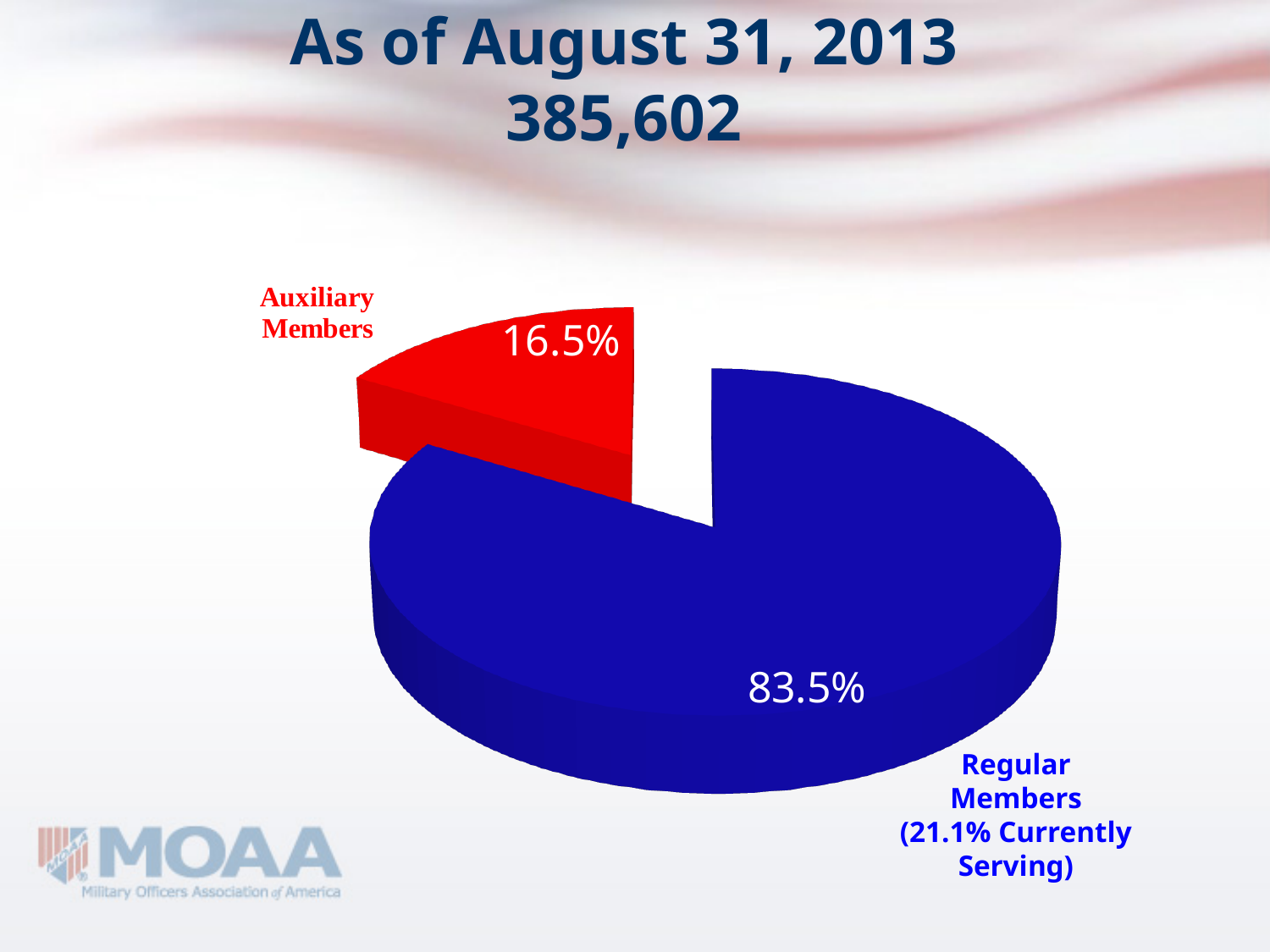
How many slices does the pie chart have? 2 According to the Regular Members label, what percentage are currently serving? 21.1% Which slice of the pie is the smallest? Auxiliary Members What is the difference in percentage points between the Regular Members slice and the Auxiliary Members slice? 67 percentage points Which slice of the pie is the largest? Regular Members What percentage of the pie is Auxiliary Members? 16.5% What total membership number is shown in the slide title? 385,602 What percentage of the pie is Regular Members? 83.5% What colour is the Auxiliary Members slice? red Which is larger, the Regular Members slice or the Auxiliary Members slice? Regular Members What kind of chart is shown on the slide? pie chart